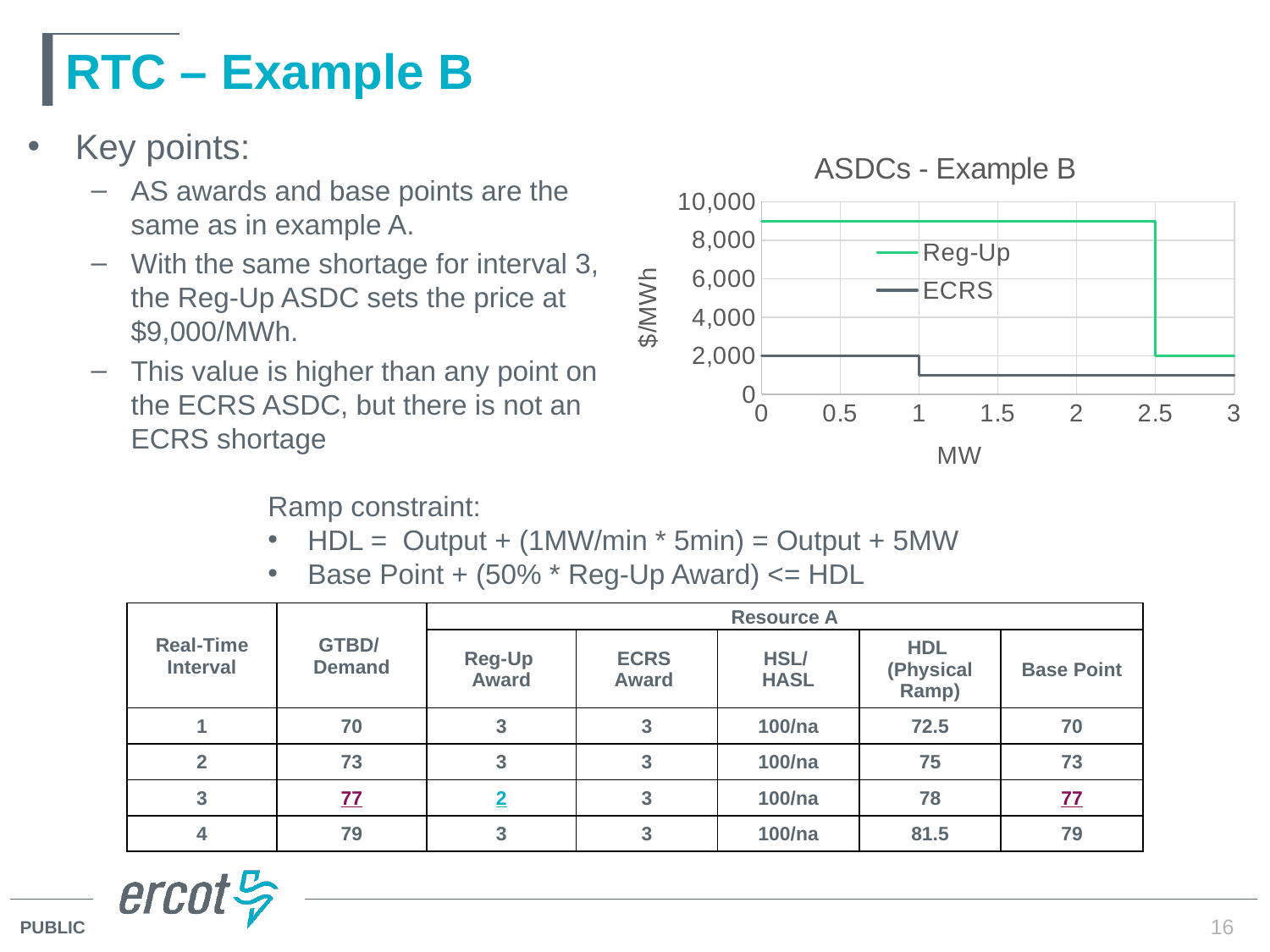
In the ASDCs - Example B chart, is the Reg-Up value at 1 MW greater or less than 8,000? greater In the ASDCs - Example B chart, does the Reg-Up line rise or fall as MW increases from 0 to 3? fall What is the highest tick value shown on the y axis of the ASDCs - Example B chart? 10,000 In the ASDCs - Example B chart, which series has the higher value at 1.5 MW, Reg-Up or ECRS? Reg-Up In the ASDCs - Example B chart, is the ECRS value at 2 MW greater or less than 2,000? less What is the title of the chart on the slide? ASDCs - Example B In the ASDCs - Example B chart, does the ECRS line rise or fall as MW increases from 0 to 3? fall How many series does the legend of the ASDCs - Example B chart list? 2 What kind of chart is shown on the slide? line chart In the ASDCs - Example B chart, is the ECRS value at 0.5 MW greater or less than 4,000? less What are the two series named in the legend of the ASDCs - Example B chart? Reg-Up and ECRS